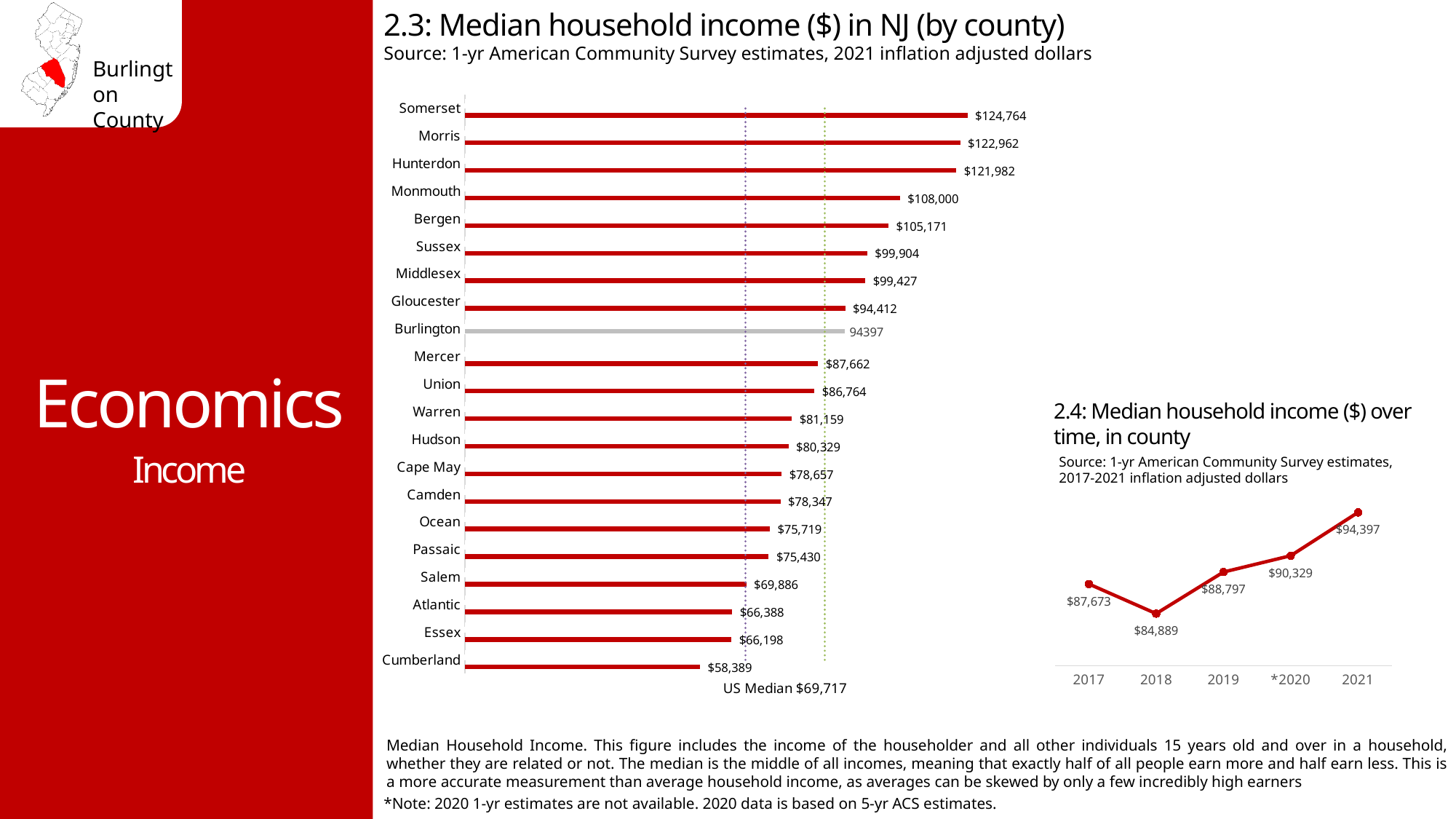
In chart 2.3 (Median household income by county), which county has the highest median household income? Somerset What kind of chart is chart 2.3 (Median household income by county)? Bar chart In chart 2.3 (Median household income by county), what is the median household income for Somerset? $124,764 In chart 2.4 (Median household income over time, in county), what is the difference between the 2021 and 2017 values? $6,724 In chart 2.3 (Median household income by county), how many counties are shown? 21 In chart 2.4 (Median household income over time, in county), what is the median household income for 2018? $84,889 In chart 2.3 (Median household income by county), which has a higher median household income, Monmouth or Bergen? Monmouth In chart 2.3 (Median household income by county), which county has the lowest median household income? Cumberland In chart 2.4 (Median household income over time, in county), how many years are plotted? 5 In chart 2.3 (Median household income by county), what is the difference between Somerset's and Cumberland's median household income? $66,375 In chart 2.3 (Median household income by county), what is the median household income for Cumberland? $58,389 In chart 2.3 (Median household income by county), what US median value is labelled on the chart? $69,717